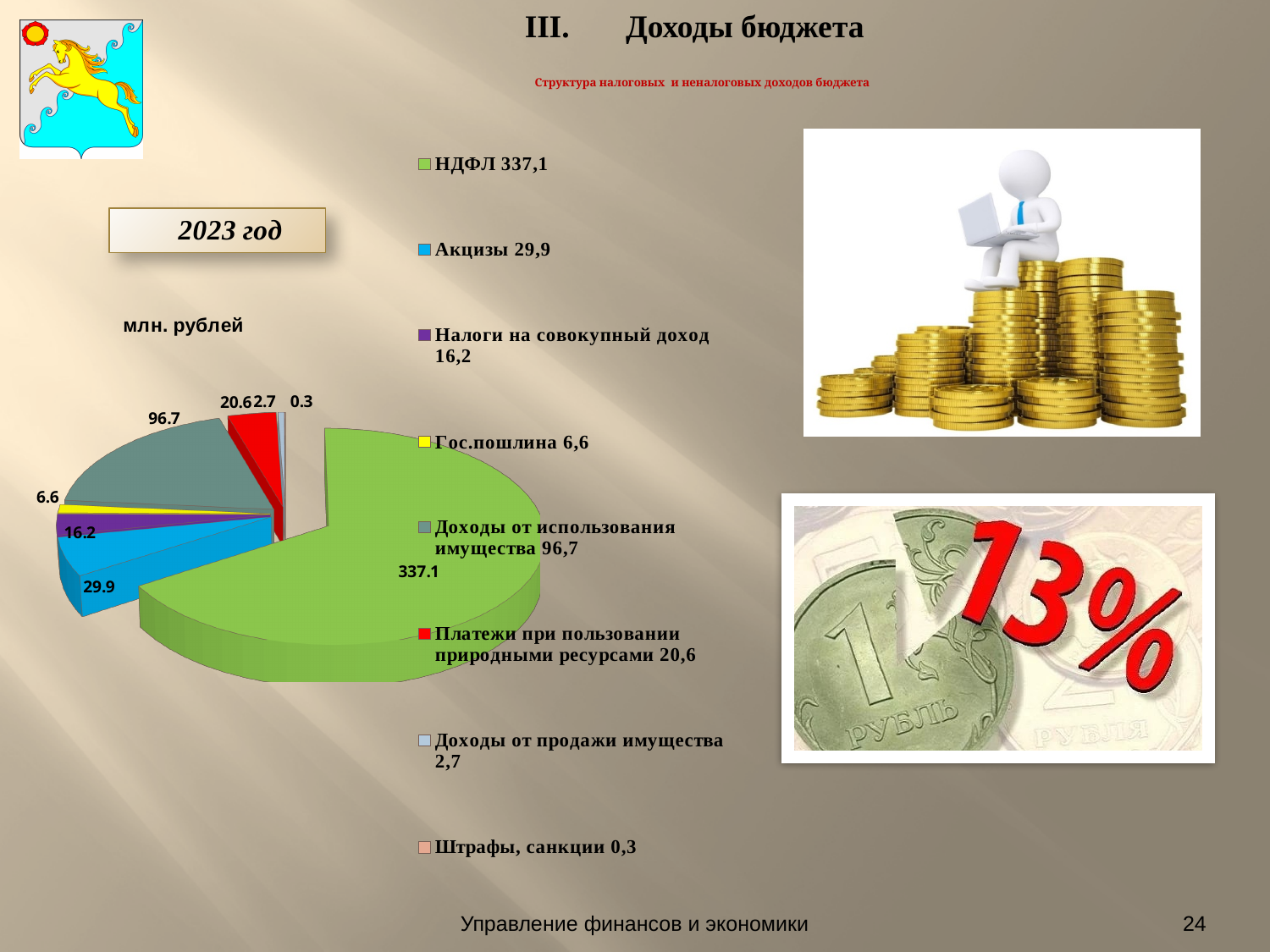
What is the difference between the values for НДФЛ and Доходы от использования имущества? 240.4 What is the value for Доходы от использования имущества in the pie chart? 96.7 Which category has the largest slice in the pie chart? НДФЛ What is the value for Акцизы in the pie chart? 29.9 What is the value for НДФЛ in the pie chart? 337.1 How many categories does the pie chart legend list? 8 Which year does the pie chart refer to? 2023 год Which category has the smallest slice in the pie chart? Штрафы, санкции What is the value for Платежи при пользовании природными ресурсами? 20.6 What unit is stated for the values in the pie chart? млн. рублей Which is larger: Акцизы or Налоги на совокупный доход? Акцизы What type of chart is shown on the slide? pie chart